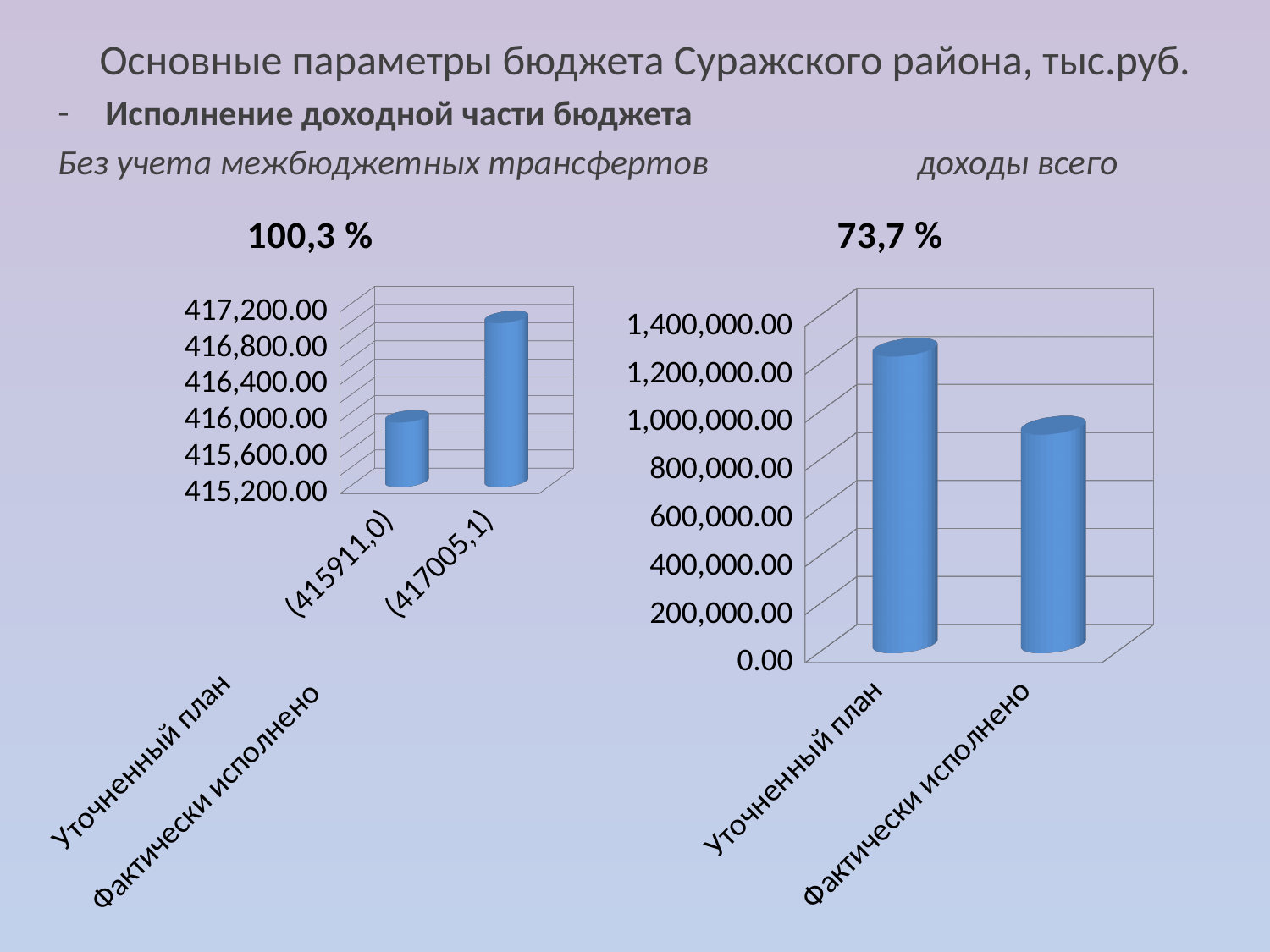
In the left chart (Без учета межбюджетных трансфертов), which category has the higher bar? Фактически исполнено How many categories are plotted in the left chart (Без учета межбюджетных трансфертов)? 2 In the right chart (доходы всего), is the value for Уточненный план greater or less than 1,000,000.00? greater What kind of chart is the left chart (Без учета межбюджетных трансфертов)? bar chart In the left chart (Без учета межбюджетных трансфертов), what value is printed in parentheses for Уточненный план? 415911,0 In the right chart (доходы всего), which category has the lower bar? Фактически исполнено In the left chart (Без учета межбюджетных трансфертов), is the value for Уточненный план greater or less than 416,000.00? less What percentage is shown above the left chart (Без учета межбюджетных трансфертов)? 100,3 % In the right chart (доходы всего), is the value for Фактически исполнено greater or less than 1,000,000.00? less In the right chart (доходы всего), which is larger: Уточненный план or Фактически исполнено? Уточненный план What percentage is shown above the right chart (доходы всего)? 73,7 %